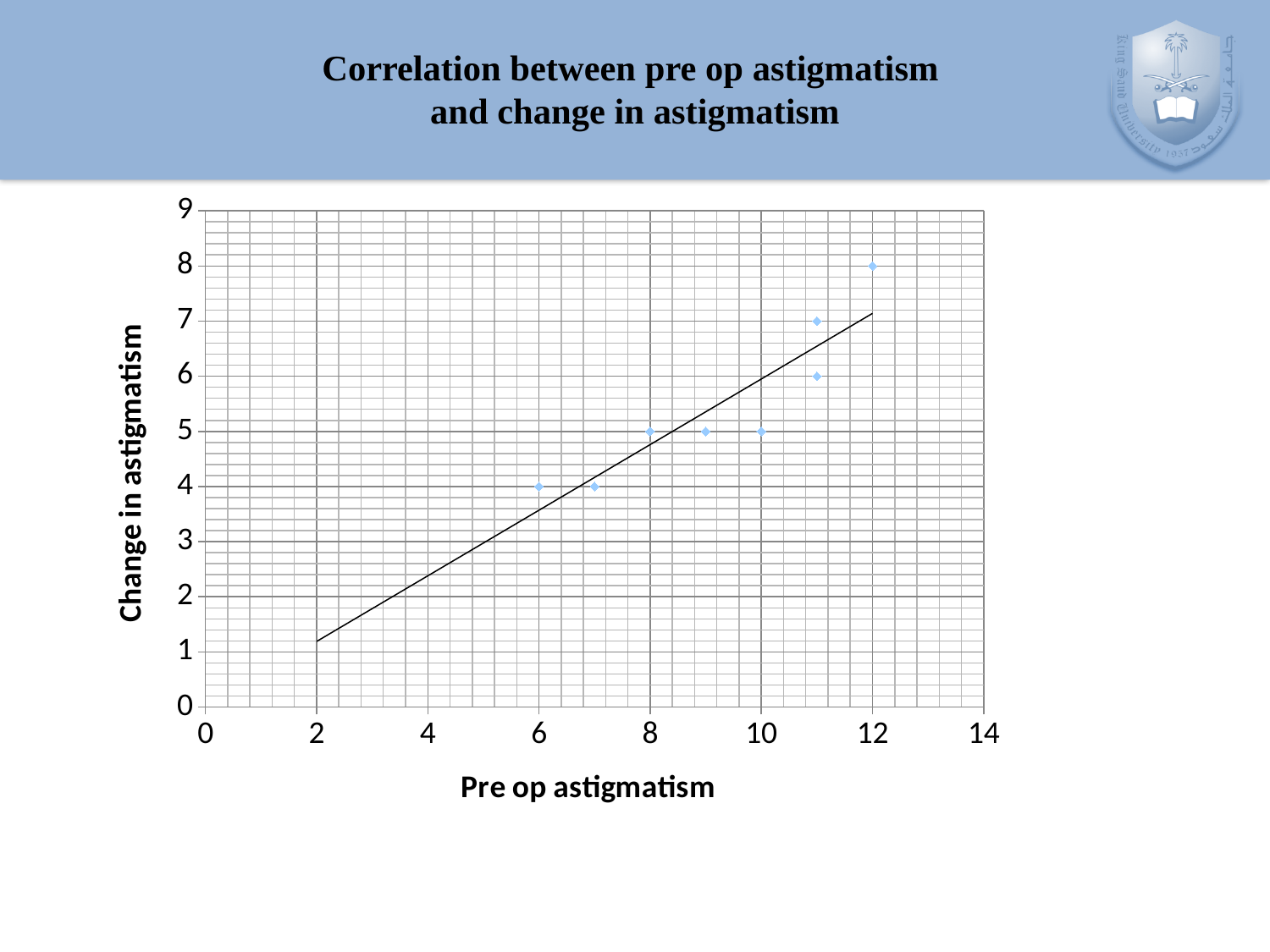
What kind of chart is shown on the slide? Scatter chart What is the title of the horizontal axis? Pre op astigmatism What is the highest change in astigmatism value plotted on the chart? 8 What is the change in astigmatism for a pre op astigmatism of 10? 5 What is the lowest change in astigmatism value plotted on the chart? 4 What is the difference in change in astigmatism between a pre op astigmatism of 12 and a pre op astigmatism of 6? 4 How many data points are plotted on the chart? 8 Do the plotted values of change in astigmatism rise or fall as pre op astigmatism increases? Rise What is the change in astigmatism for a pre op astigmatism of 12? 8 Which has the larger change in astigmatism: a pre op astigmatism of 12 or a pre op astigmatism of 6? 12 What is the change in astigmatism for a pre op astigmatism of 6? 4 What is the change in astigmatism for a pre op astigmatism of 8? 5